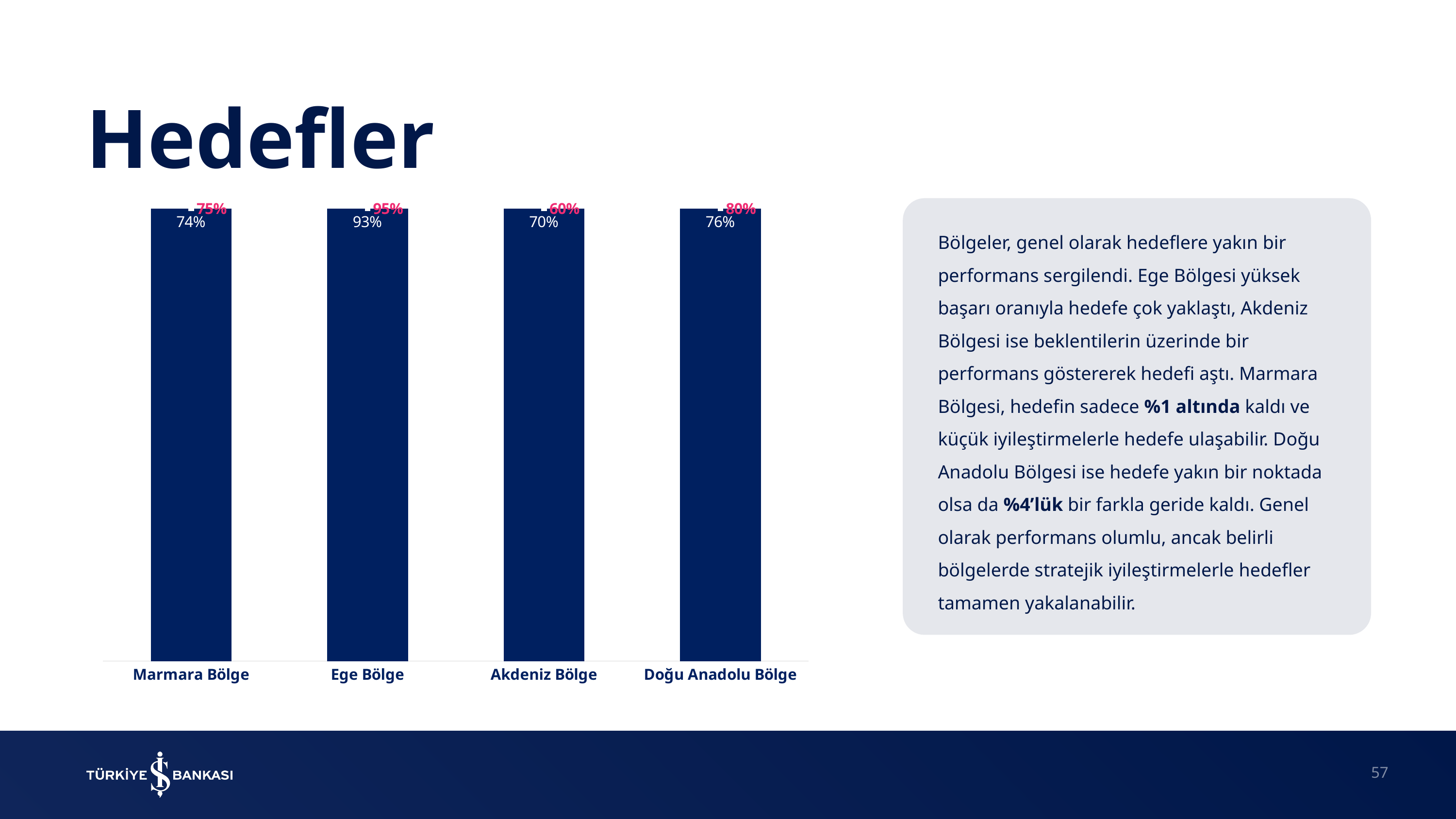
What is the value shown for Ege Bölge? 93% What is the target (pink label) shown above the Akdeniz Bölge bar? 60% Which region has the lowest value according to the data labels? Akdeniz Bölge What kind of chart is shown on the slide? Bar chart What is the value shown for Doğu Anadolu Bölge? 76% What is the target (pink label) shown above the Marmara Bölge bar? 75% What is the value shown for Akdeniz Bölge? 70% By how much does the Doğu Anadolu Bölge value (76%) fall short of its target (80%)? 4% What is the value shown for Marmara Bölge? 74% By how much does the Ege Bölge value (93%) fall short of its target (95%)? 2% How many regions are shown on the chart? 4 Which region has the highest value according to the data labels? Ege Bölge